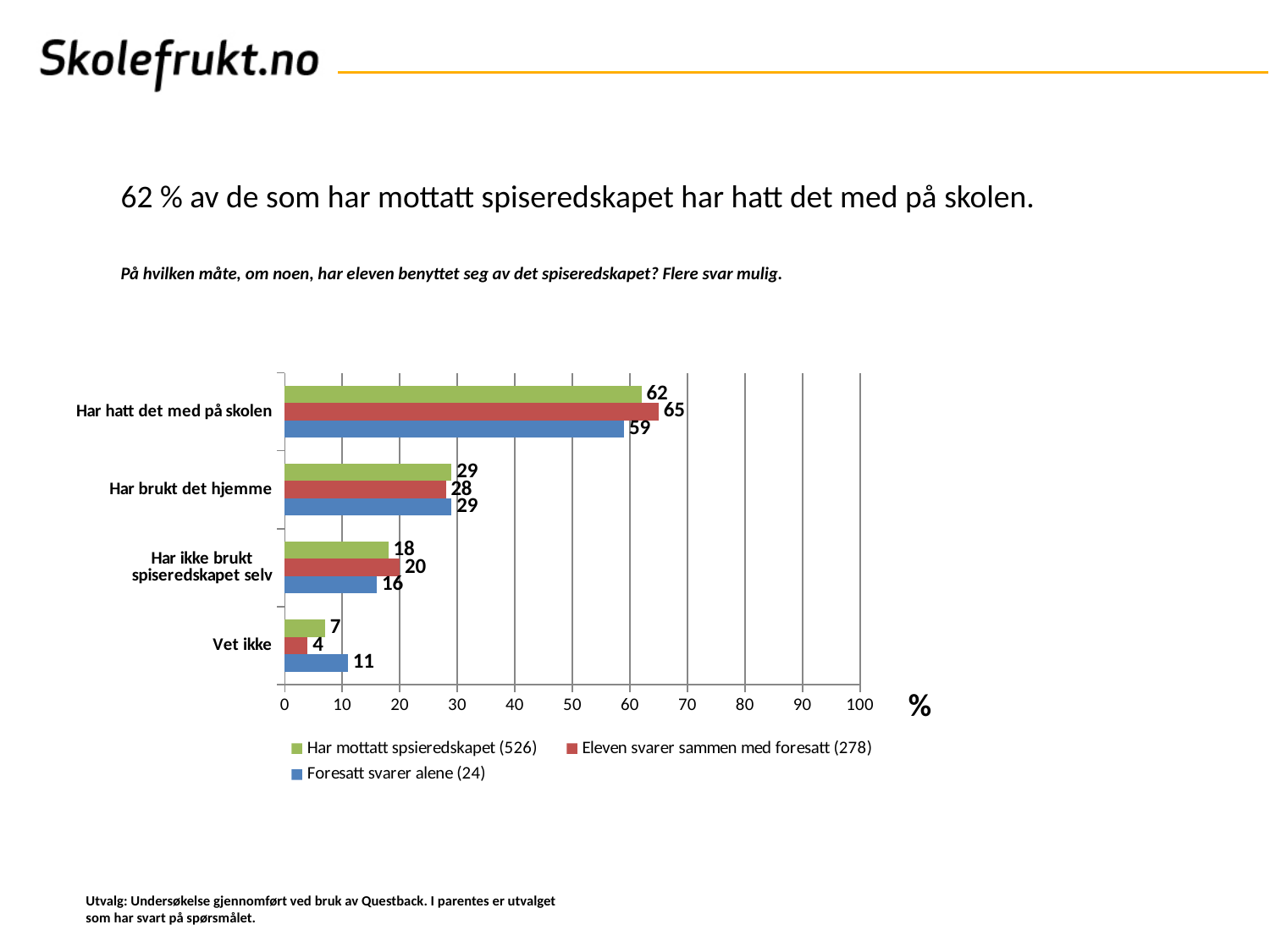
What is the value for "Har ikke brukt spiseredskapet selv" in the "Eleven svarer sammen med foresatt (278)" series? 20 What is the value for "Har hatt det med på skolen" in the "Har mottatt spsieredskapet (526)" series? 62 What kind of chart is shown on the slide? bar chart Is the value for "Har brukt det hjemme" in the "Foresatt svarer alene (24)" series greater or less than 40? less How many series does the legend list? 3 Which category has the lowest value in the "Har mottatt spsieredskapet (526)" series? Vet ikke For "Vet ikke", which series has the larger value: "Har mottatt spsieredskapet (526)" or "Foresatt svarer alene (24)"? Foresatt svarer alene (24) What is the difference between the "Eleven svarer sammen med foresatt (278)" and "Foresatt svarer alene (24)" values for "Har hatt det med på skolen"? 6 How many categories are shown on the chart? 4 What is the value for "Vet ikke" in the "Foresatt svarer alene (24)" series? 11 What colour represents the "Foresatt svarer alene (24)" series? blue Which category has the highest value in the "Eleven svarer sammen med foresatt (278)" series? Har hatt det med på skolen